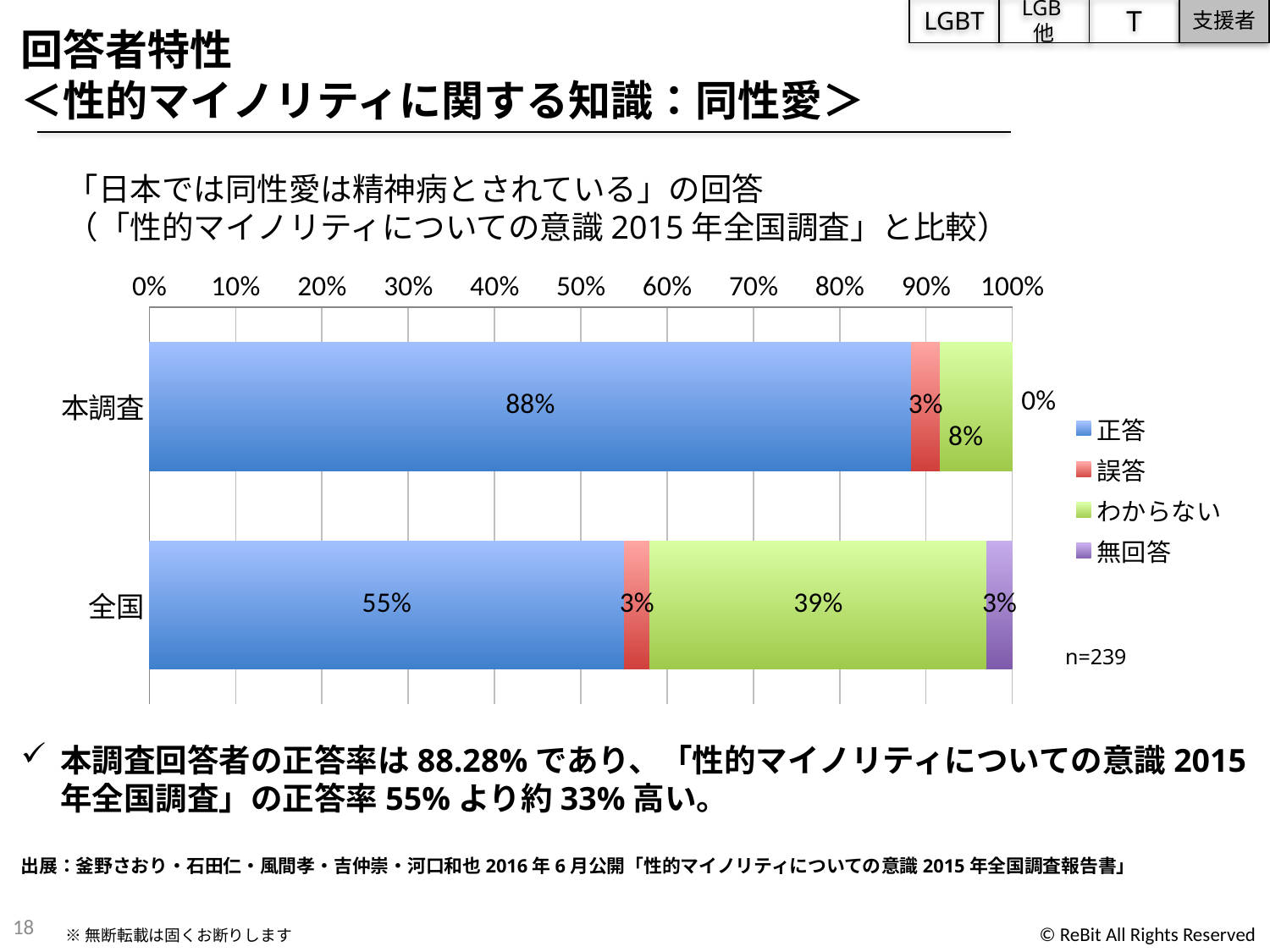
What is the 正答 value for 本調査? 88% What is the 無回答 value for 全国? 3% Which legend entry is shown in green? わからない How many series does the legend list? 4 Which series is the largest segment in the 本調査 bar? 正答 What kind of chart is shown on the slide? Stacked bar chart What is the 正答 value for 全国? 55% Which category has the higher 正答 value, 本調査 or 全国? 本調査 How many categories (bars) are plotted in the chart? 2 What is the わからない value for 本調査? 8% What is the わからない value for 全国? 39% What is the difference between the 正答 values for 本調査 and 全国? 33%